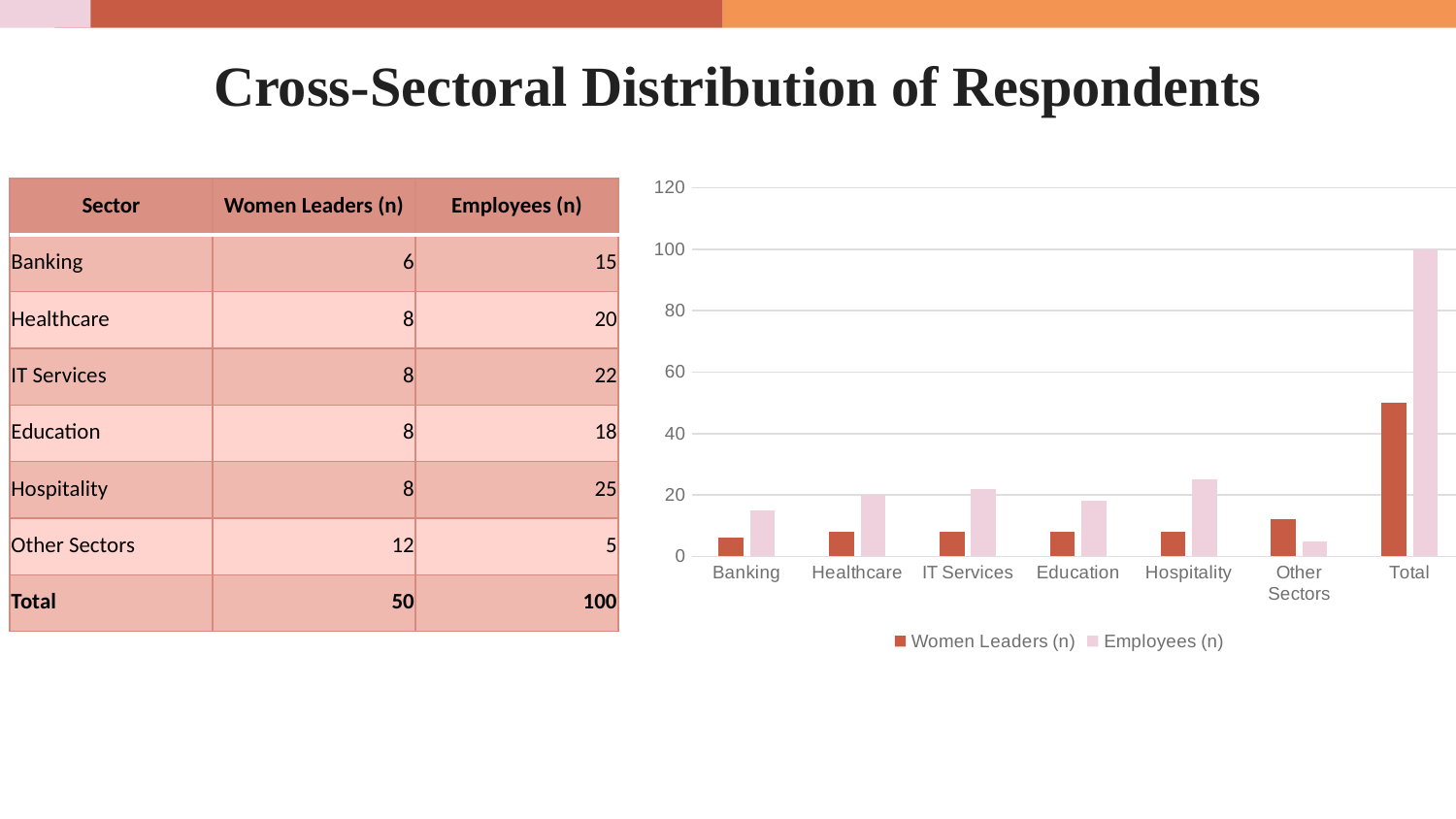
Excluding Total, which sector has the highest Employees (n) value? Hospitality What is the Women Leaders (n) value for Other Sectors? 12 What is the difference between the Employees (n) and Women Leaders (n) values for Total? 50 What is the Employees (n) value for the Total category? 100 Is the Employees (n) value for Banking greater or less than 20? less How many categories are shown on the x axis of the chart? 7 What is the Employees (n) value for Hospitality? 25 What kind of chart is shown on the slide? bar chart Is the Women Leaders (n) value for Total greater or less than 40? greater Which sector has the lowest Employees (n) value? Other Sectors Which is larger for Other Sectors: Women Leaders (n) or Employees (n)? Women Leaders (n) How many series does the chart legend list? 2